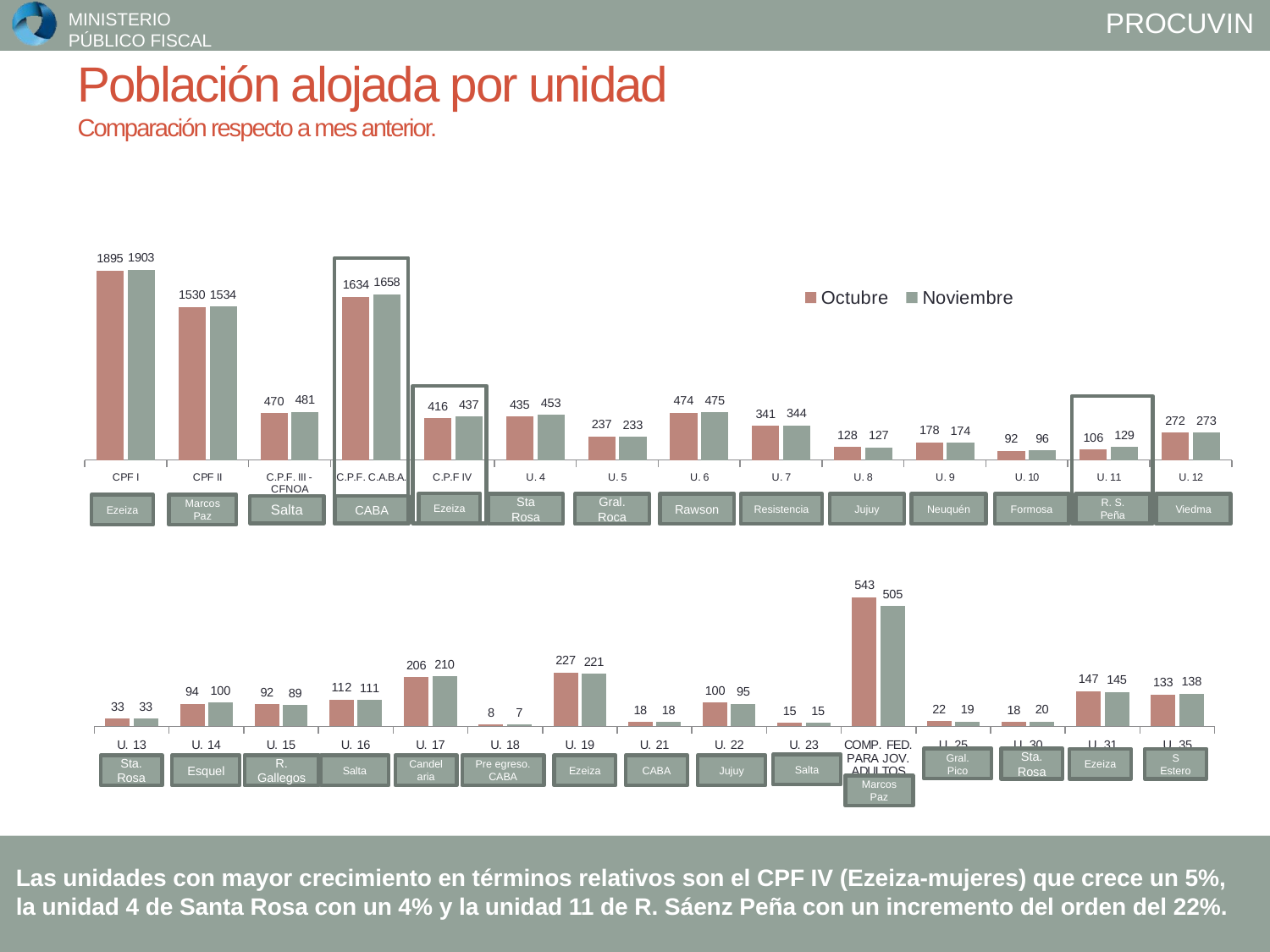
In the top chart, which category has the highest Octubre value? CPF I In the bottom chart, which category has the lowest Noviembre value? U. 18 In the bottom chart, what is the Octubre value for COMP. FED. PARA JOV. ADULTOS? 543 In the top chart, what is the difference between the Noviembre and Octubre values for C.P.F. C.A.B.A.? 24 In the top chart, which is larger for U. 5: the Octubre value or the Noviembre value? Octubre How many categories are shown in the bottom chart? 15 In the top chart, what is the Noviembre value for CPF I? 1903 In the bottom chart, what is the difference between the Octubre and Noviembre values for U. 19? 6 In the top chart, what is the Octubre value for U. 11? 106 How many series does the legend of the top chart list? 2 In the top chart, which category has the lowest Noviembre value? U. 10 What kind of chart is the bottom chart? Bar chart